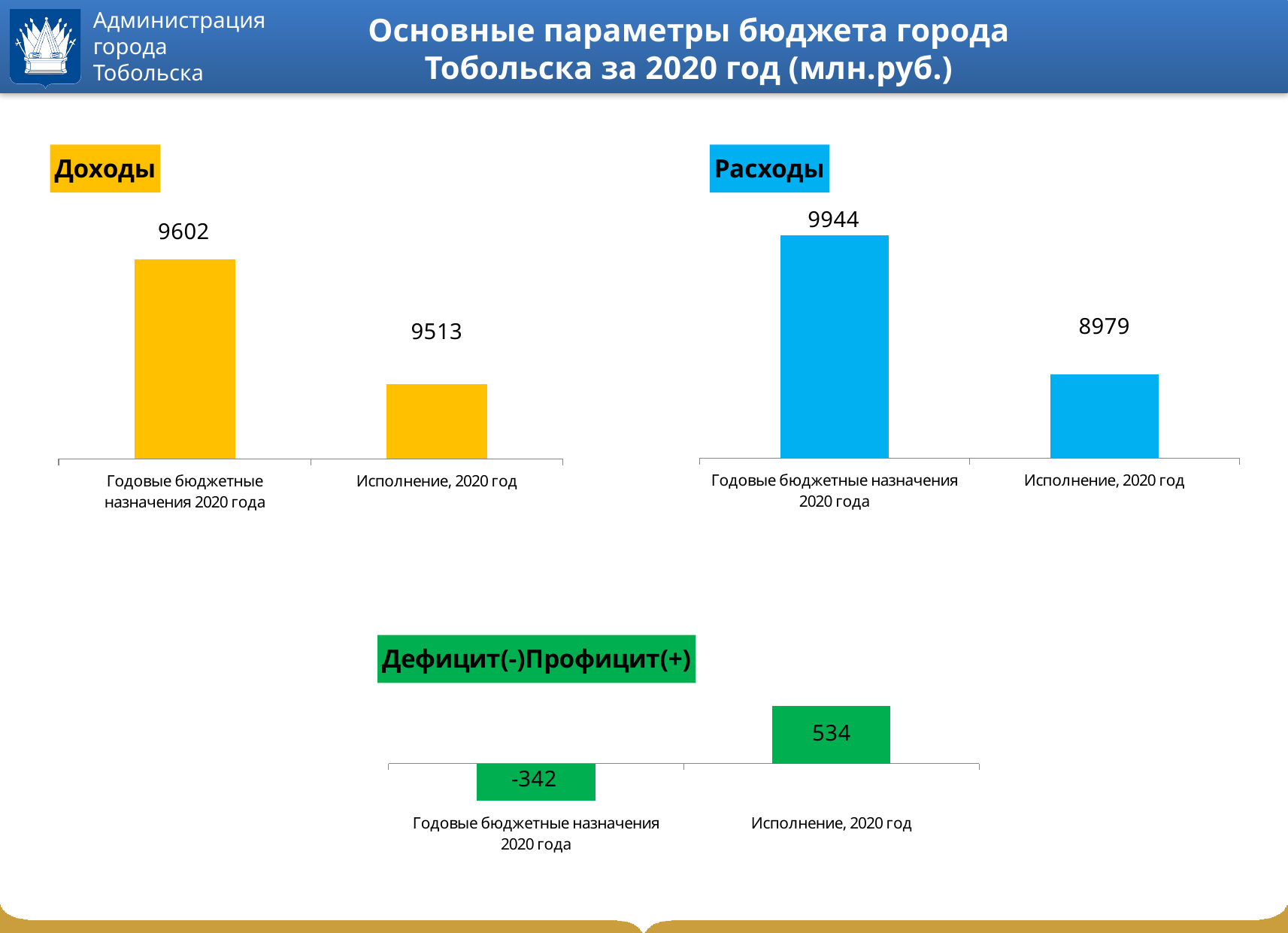
In the Доходы chart, what is the difference between Годовые бюджетные назначения 2020 года and Исполнение, 2020 год? 89 In the Дефицит(-)Профицит(+) chart, which category has the lowest value? Годовые бюджетные назначения 2020 года In the Доходы chart, what is the value for Годовые бюджетные назначения 2020 года? 9602 In the Доходы chart, what is the value for Исполнение, 2020 год? 9513 In the Расходы chart, what is the value for Исполнение, 2020 год? 8979 In the Дефицит(-)Профицит(+) chart, what is the value for Исполнение, 2020 год? 534 In the Расходы chart, what is the difference between Годовые бюджетные назначения 2020 года and Исполнение, 2020 год? 965 What type of chart is the Расходы chart? Bar chart In the Расходы chart, what is the value for Годовые бюджетные назначения 2020 года? 9944 In the Расходы chart, which category has the highest value? Годовые бюджетные назначения 2020 года How many categories does the Доходы chart show? 2 In the Дефицит(-)Профицит(+) chart, what is the value for Годовые бюджетные назначения 2020 года? -342